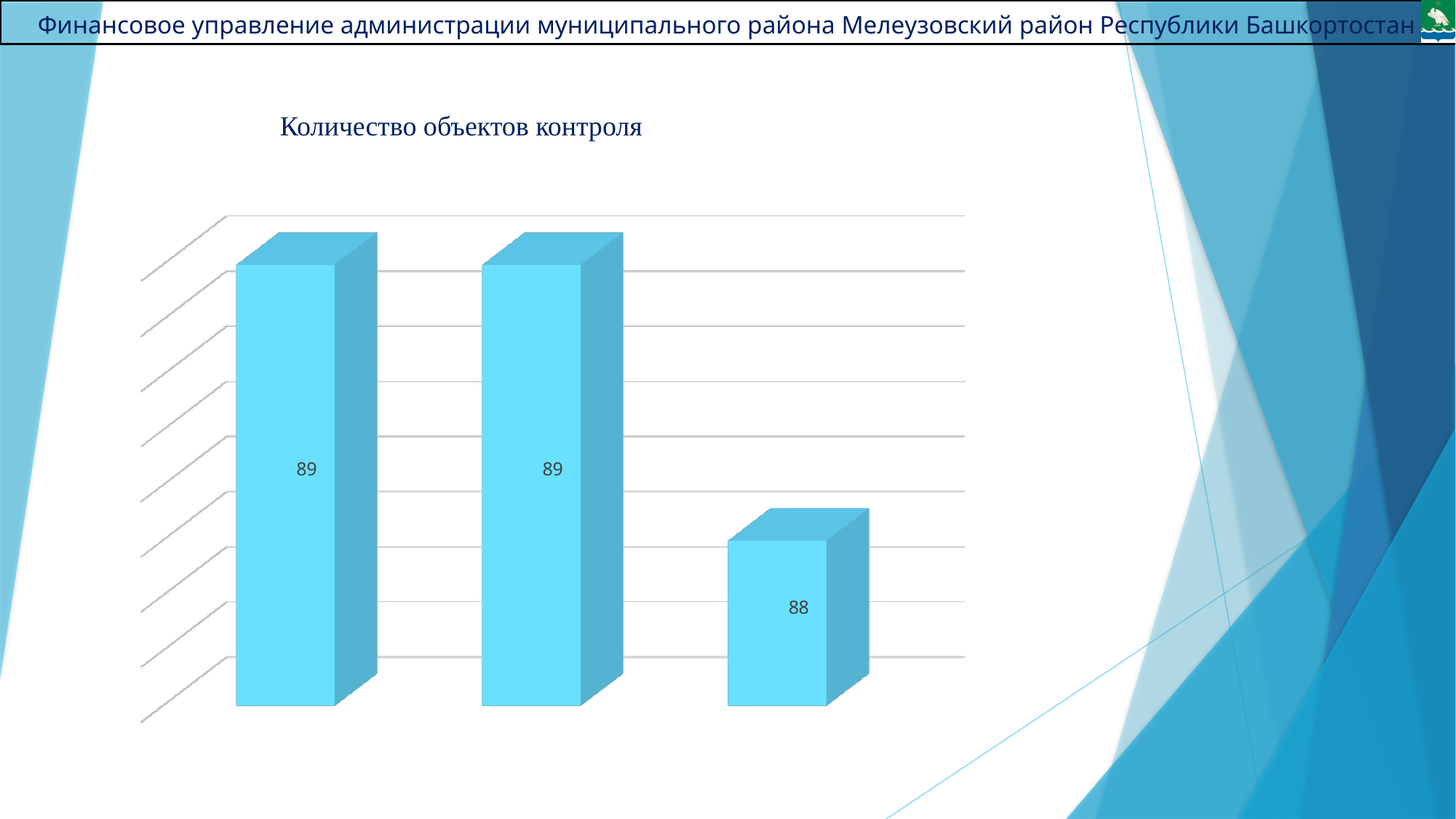
What is the value of the first (leftmost) bar? 89 What colour are the bars in the chart? light blue Do the values rise or fall from the left bar to the right bar? fall What is the value of the middle bar? 89 What is the title of the chart? Количество объектов контроля Which bar has the lowest value? the third (rightmost) bar What type of chart is shown on the slide? bar chart How many bars are plotted in the chart? 3 What is the difference between the value of the first bar and the value of the third bar? 1 Which is larger, the value of the first bar or the value of the third bar? the first bar What is the value of the third (rightmost) bar? 88